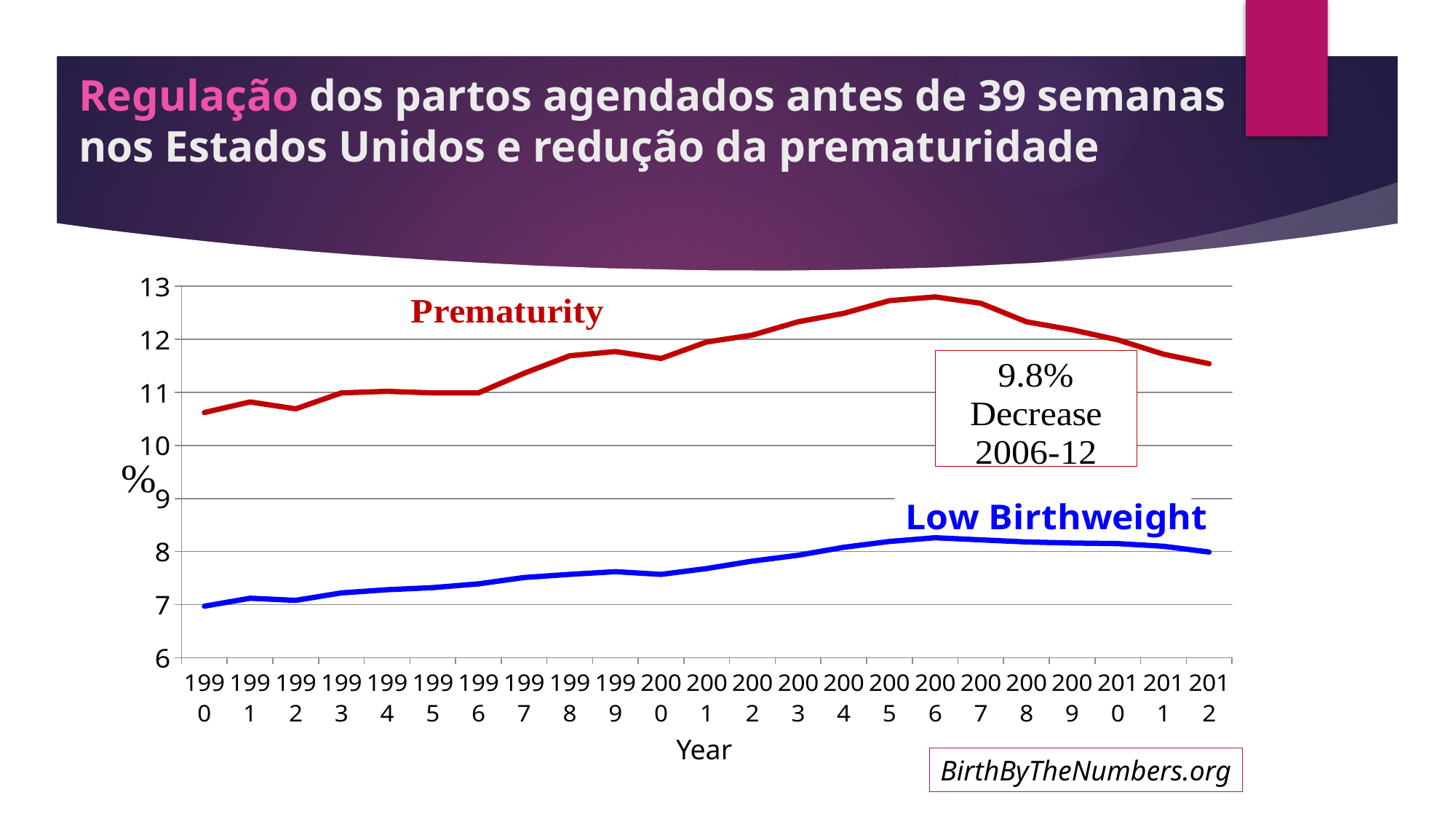
Is the Prematurity value for 1990 greater or less than 11? less Is the Prematurity value for 2000 greater or less than 12? less In 2006, which series has the larger value, Prematurity or Low Birthweight? Prematurity In which year does the Prematurity line reach its highest value? 2006 Does the Prematurity line rise or fall from 2006 to 2012? fall What decrease does the text box on the chart report for 2006-12? 9.8% How many years are shown along the x axis of the chart? 23 How many series are plotted on the chart? 2 Is the Prematurity value for 2006 greater or less than 12? greater What kind of chart is shown on the slide? line chart